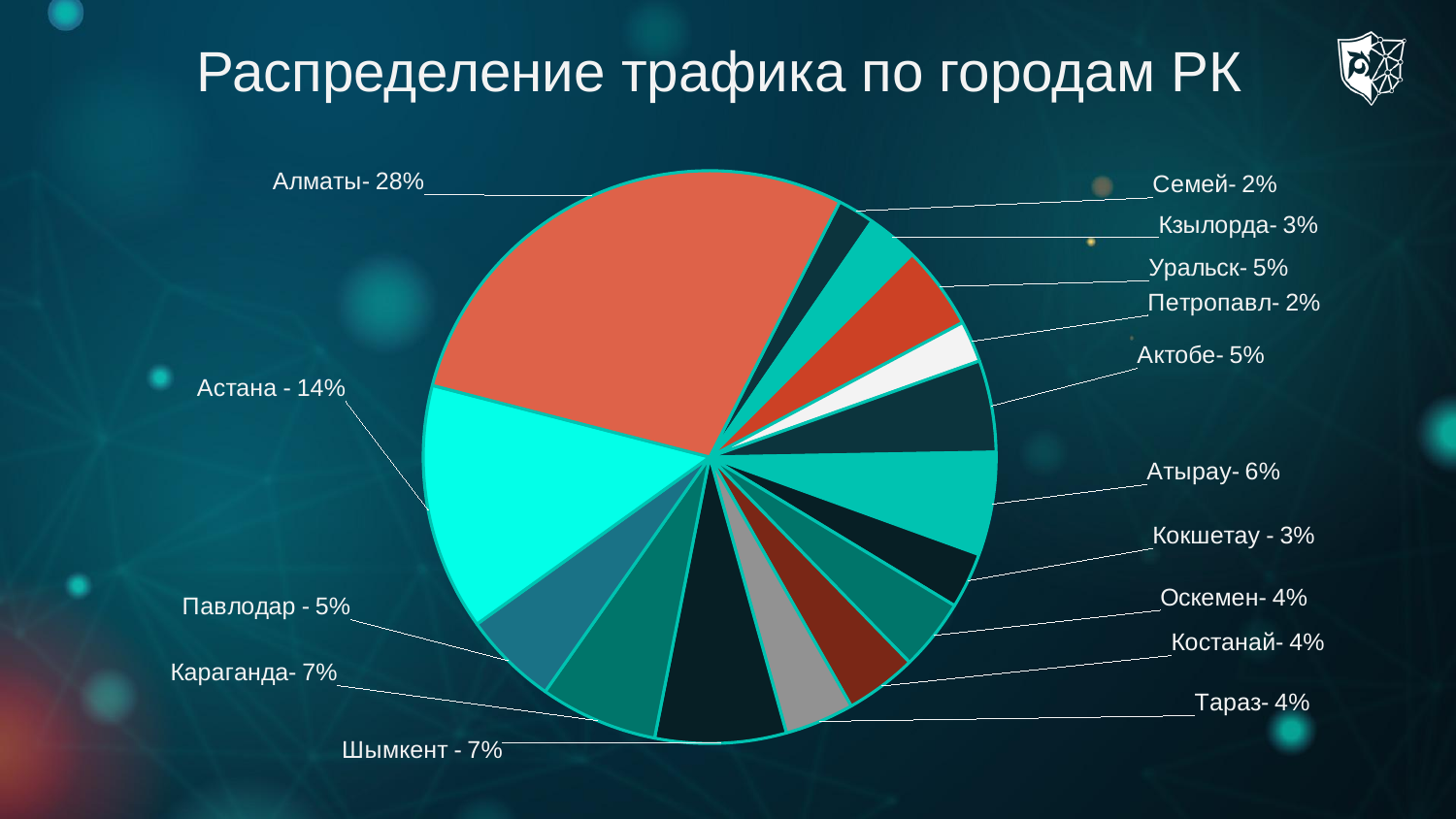
What is the difference between the shares of Алматы and Астана? 14% What kind of chart is shown on the slide? pie chart What is the value shown for Кзылорда? 3% What is the value shown for Атырау? 6% What is the title of the chart? Распределение трафика по городам РК What share of traffic does Астана have? 14% What share of traffic does Алматы have? 28% Which city has the largest share of traffic? Алматы Which has a larger share, Караганда or Павлодар? Караганда Which has a larger share, Атырау or Оскемен? Атырау How many cities are shown in the pie chart? 15 What is the difference between the shares of Уральск and Семей? 3%